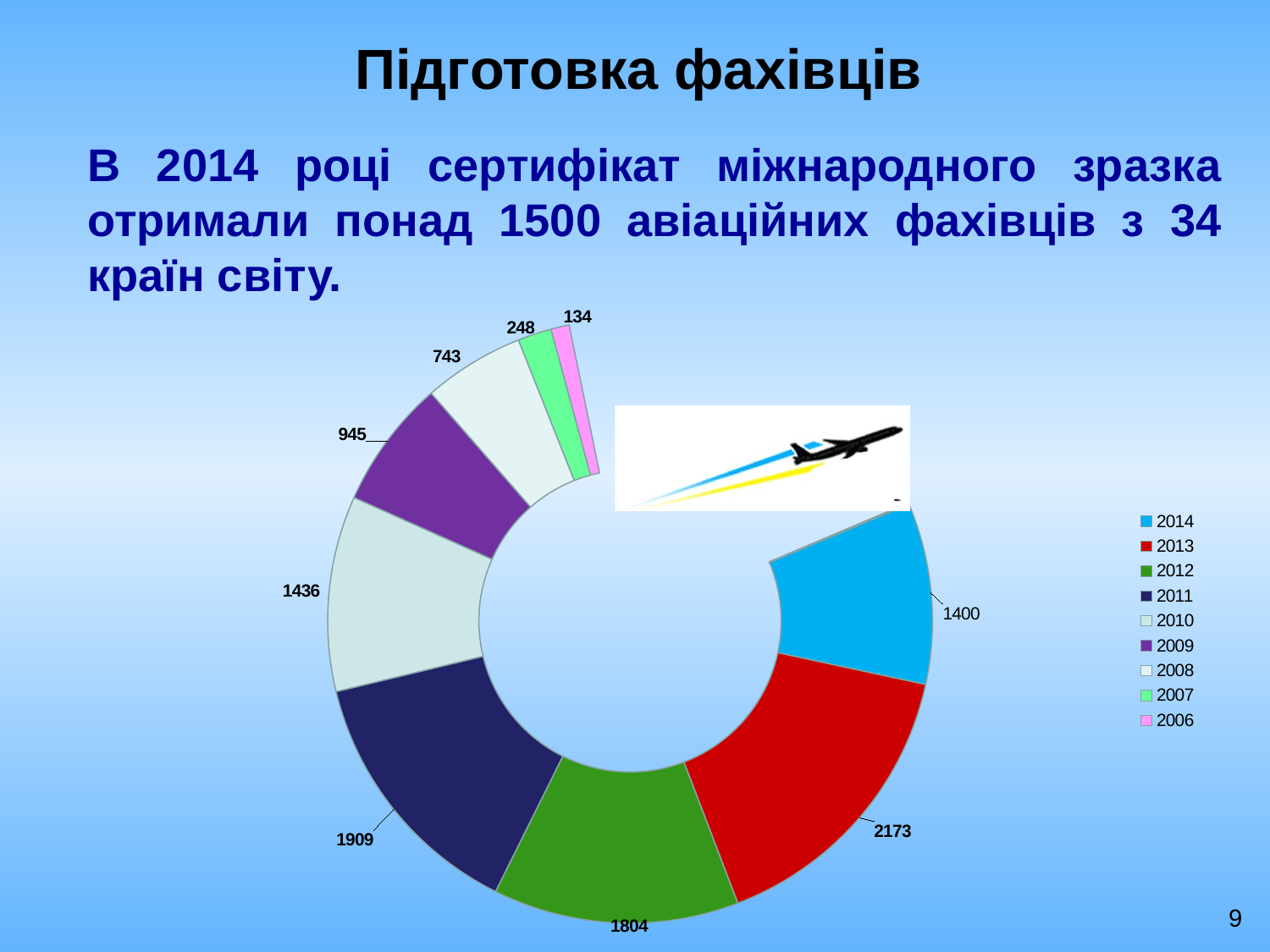
What value is shown for 2006 in the doughnut chart? 134 What value is shown for 2010 in the doughnut chart? 1436 What kind of chart is shown on the slide? doughnut chart Which year has the lowest value in the doughnut chart? 2006 What is the difference between the values for 2011 and 2012? 105 Which is larger, the value for 2009 or the value for 2008? 2009 Which colour represents 2014 in the legend? light blue What value is shown for 2014 in the doughnut chart? 1400 What is the difference between the values for 2013 and 2014? 773 What value is shown for 2013 in the doughnut chart? 2173 Which year has the highest value in the doughnut chart? 2013 How many years (segments) does the doughnut chart show? 9